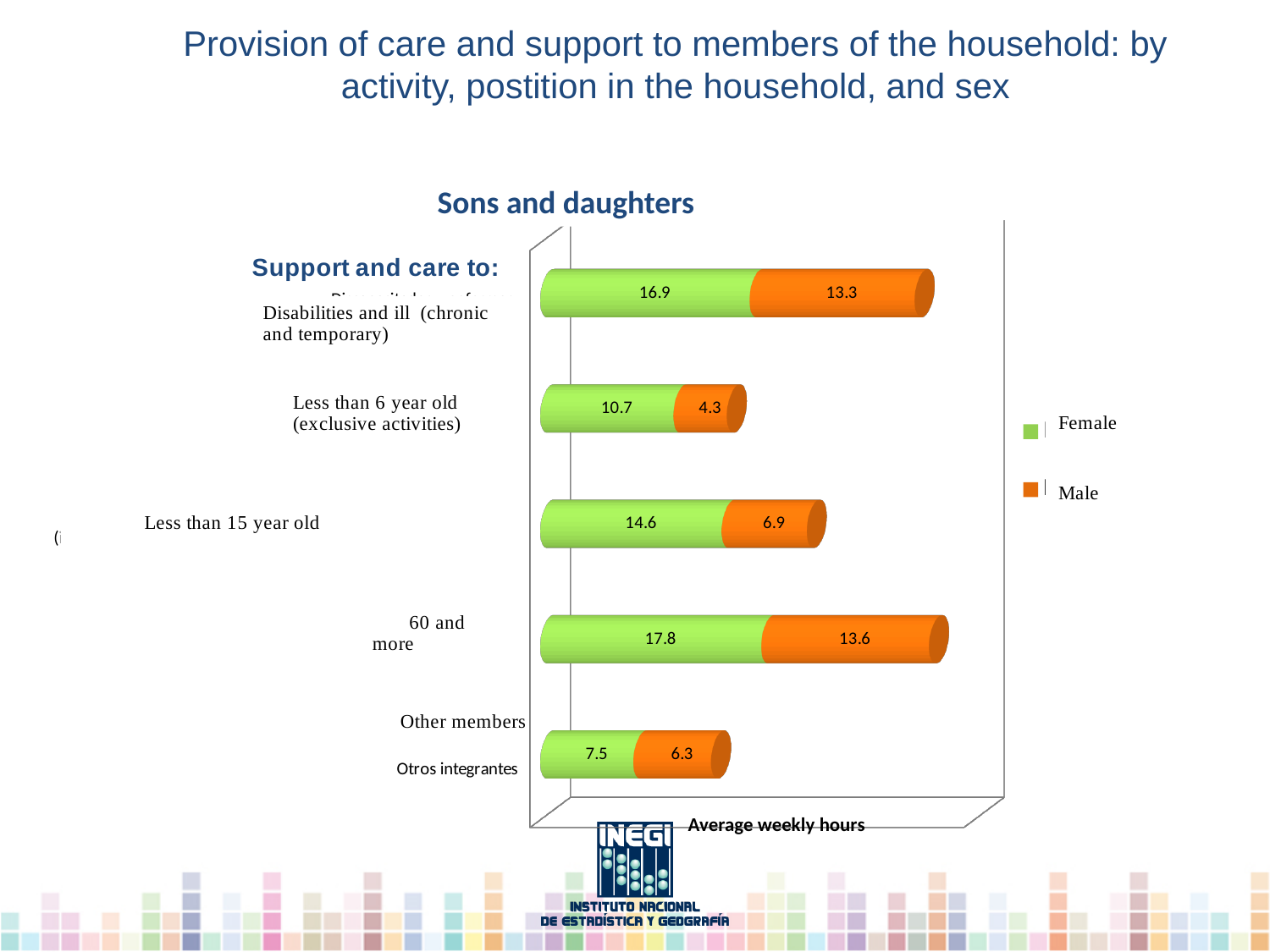
What is the difference between the Female and Male values for "Less than 15 year old"? 7.7 How many series does the legend list? 2 What kind of chart is shown on the slide? Stacked bar chart Which category has the lowest Male value? Less than 6 year old (exclusive activities) What is the Male value for "Less than 6 year old (exclusive activities)"? 4.3 What is the total of the stacked bar for "60 and more"? 31.4 Which is larger for "Other members": the Female value or the Male value? Female What is the title of the chart? Sons and daughters What is the Male value for "Disabilities and ill (chronic and temporary)"? 13.3 What is the Female value for "60 and more"? 17.8 Which category has the highest Female value? 60 and more How many categories are shown in the chart? 5